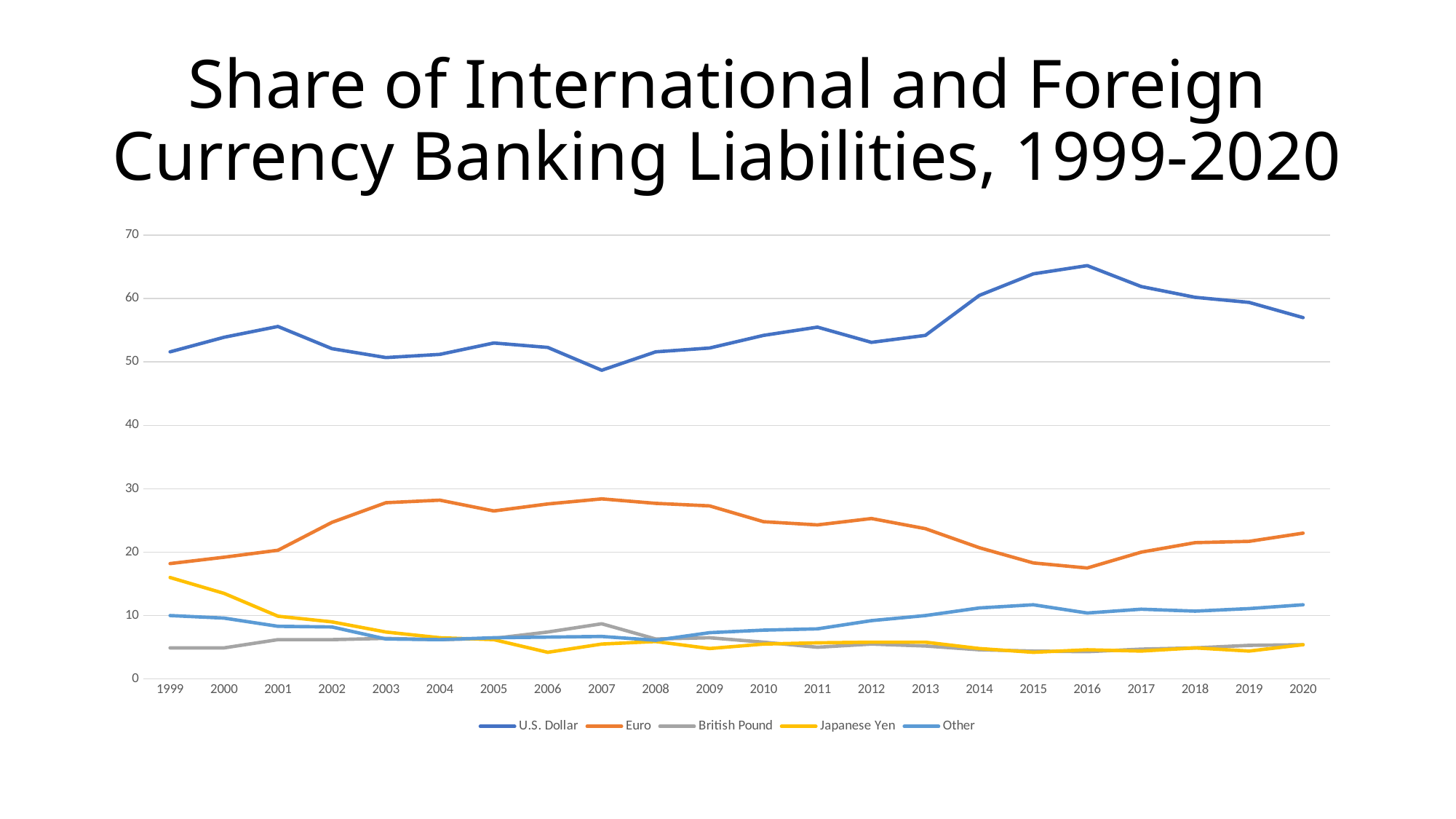
In which year does the U.S. Dollar line reach its peak? 2016 In 1999, which is larger: the Euro value or the Japanese Yen value? Euro How many years are plotted along the x axis? 22 How many series does the legend list? 5 Is the value for Japanese Yen in 1999 greater or less than 10? greater Which series has the highest values across the whole period? U.S. Dollar Is the value for U.S. Dollar in 2007 greater or less than 50? less What is the title of the chart? Share of International and Foreign Currency Banking Liabilities, 1999-2020 Is the value for Euro in 2016 greater or less than 20? less What kind of chart is shown on the slide? line chart Does the Japanese Yen line rise or fall from 1999 to 2005? fall